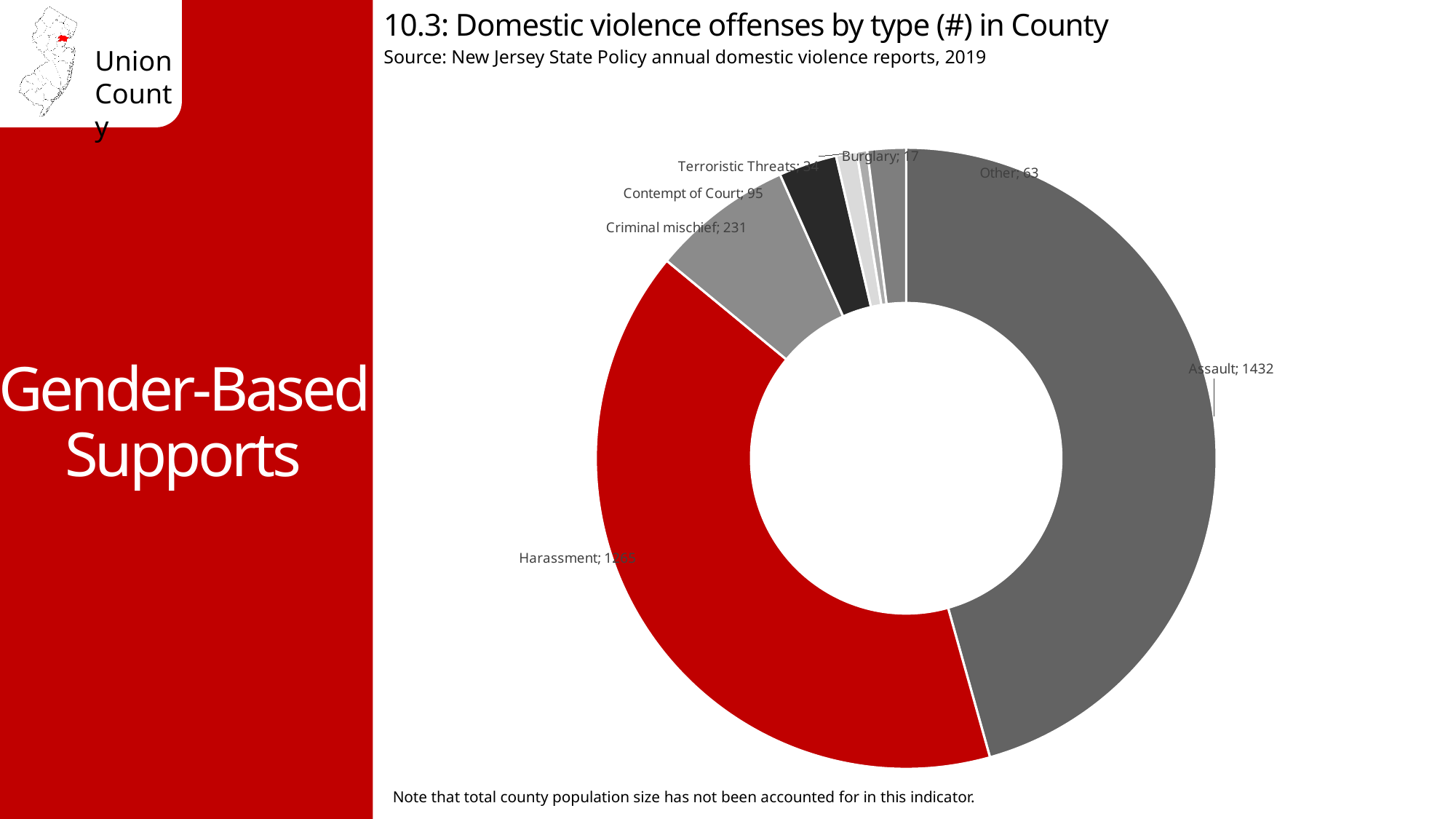
What is the value for Burglary? 17 What year of data does the chart's source line cite? 2019 What is the value for the Other category? 63 How many offense types are shown in the chart? 7 What is the value for Contempt of Court? 95 What is the difference between the Assault and Criminal mischief values? 1201 What type of chart is shown on the slide? Doughnut (pie) chart Which offense type has the smallest slice in the chart? Burglary What is the number of Assault offenses shown in the chart? 1432 Which offense type has the largest slice in the chart? Assault Which is larger, Criminal mischief or Contempt of Court? Criminal mischief What is the value for Criminal mischief? 231